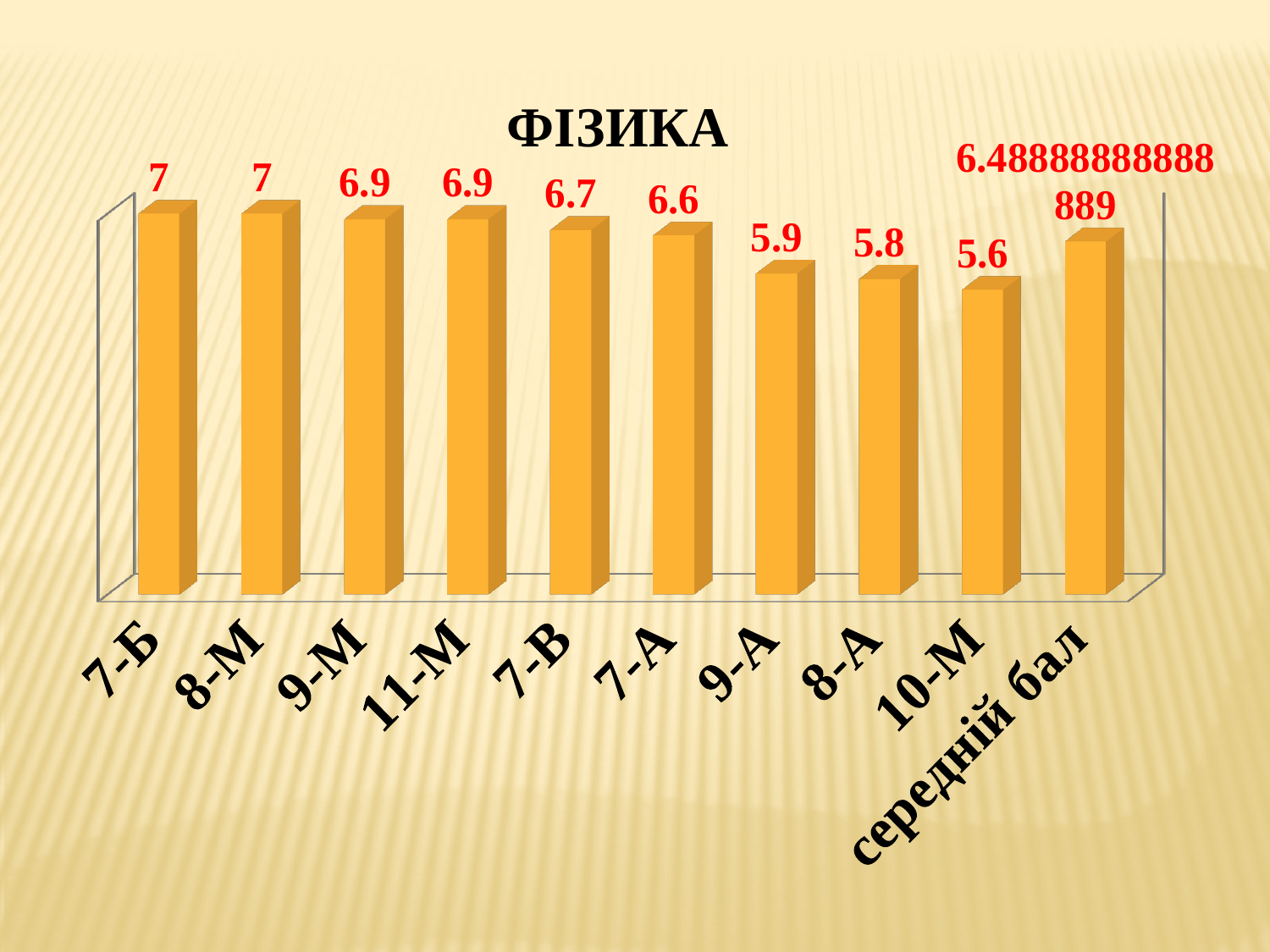
What is the value for 11-М? 6.9 Which is larger, the value for 9-М or the value for 9-А? 9-М Which category has the lowest value? 10-М What kind of chart is this? bar chart What is the value for 10-М? 5.6 How many categories are shown on the x axis? 10 What is the difference between the values for 7-Б and 10-М? 1.4 What is the difference between the values for 7-А and 8-А? 0.8 What is the value shown for середній бал? 6.48888888888889 What is the value for 7-В? 6.7 What is the title of the chart? ФІЗИКА What is the value for 9-А? 5.9